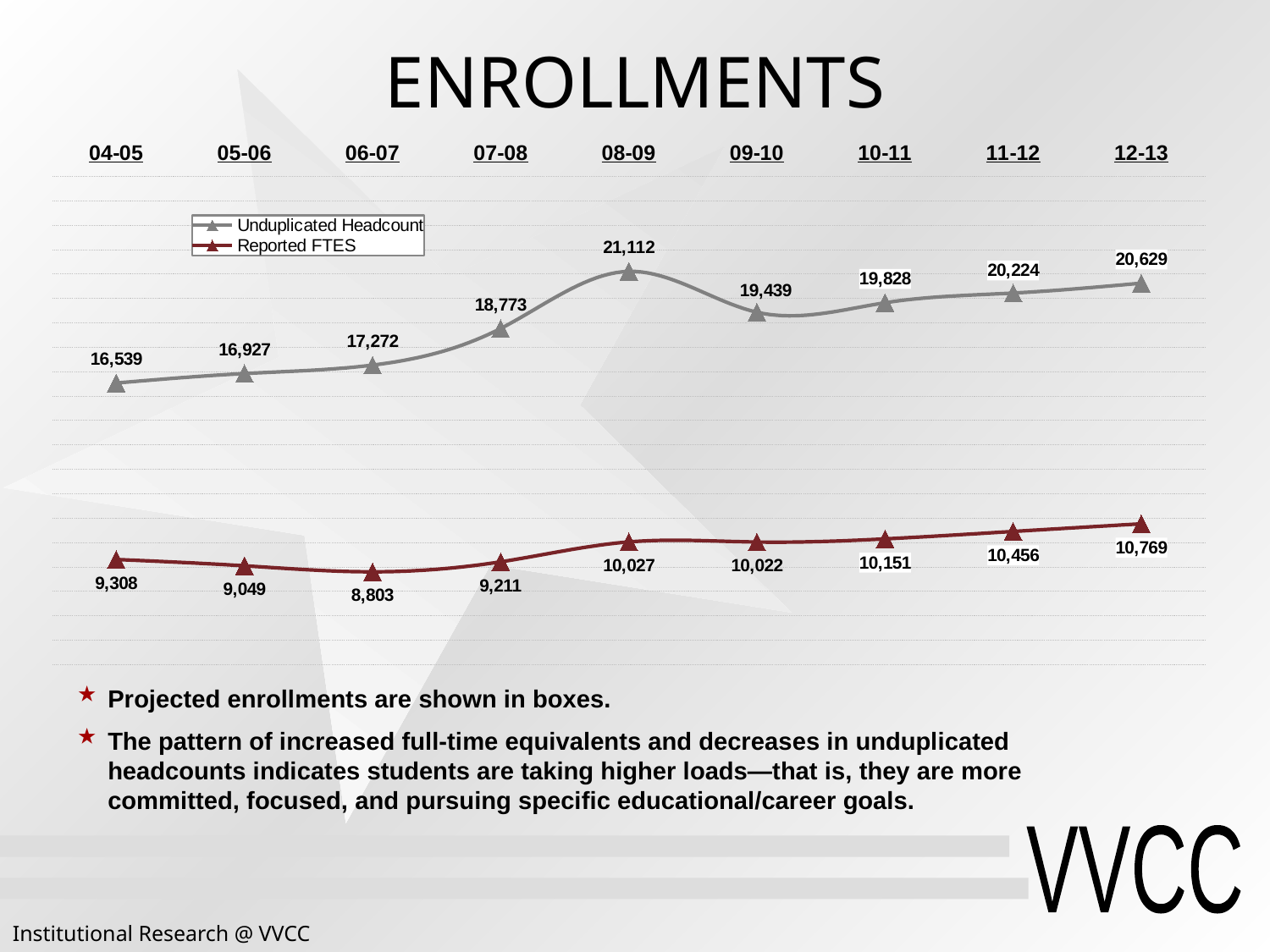
Which year has the highest Unduplicated Headcount? 08-09 Which is larger, the Reported FTES for 08-09 or for 09-10? 08-09 Which year has the lowest Reported FTES? 06-07 How many academic years are plotted on the chart? 9 How many series does the legend list? 2 What kind of chart is shown on the slide? Line chart What is the Unduplicated Headcount for 08-09? 21,112 What is the difference between the Unduplicated Headcount in 08-09 and in 09-10? 1,673 What is the difference between Reported FTES in 12-13 and in 04-05? 1,461 Does the Unduplicated Headcount rise or fall from 04-05 to 08-09? Rise What is the Reported FTES value for 06-07? 8,803 What is the Unduplicated Headcount for 12-13? 20,629